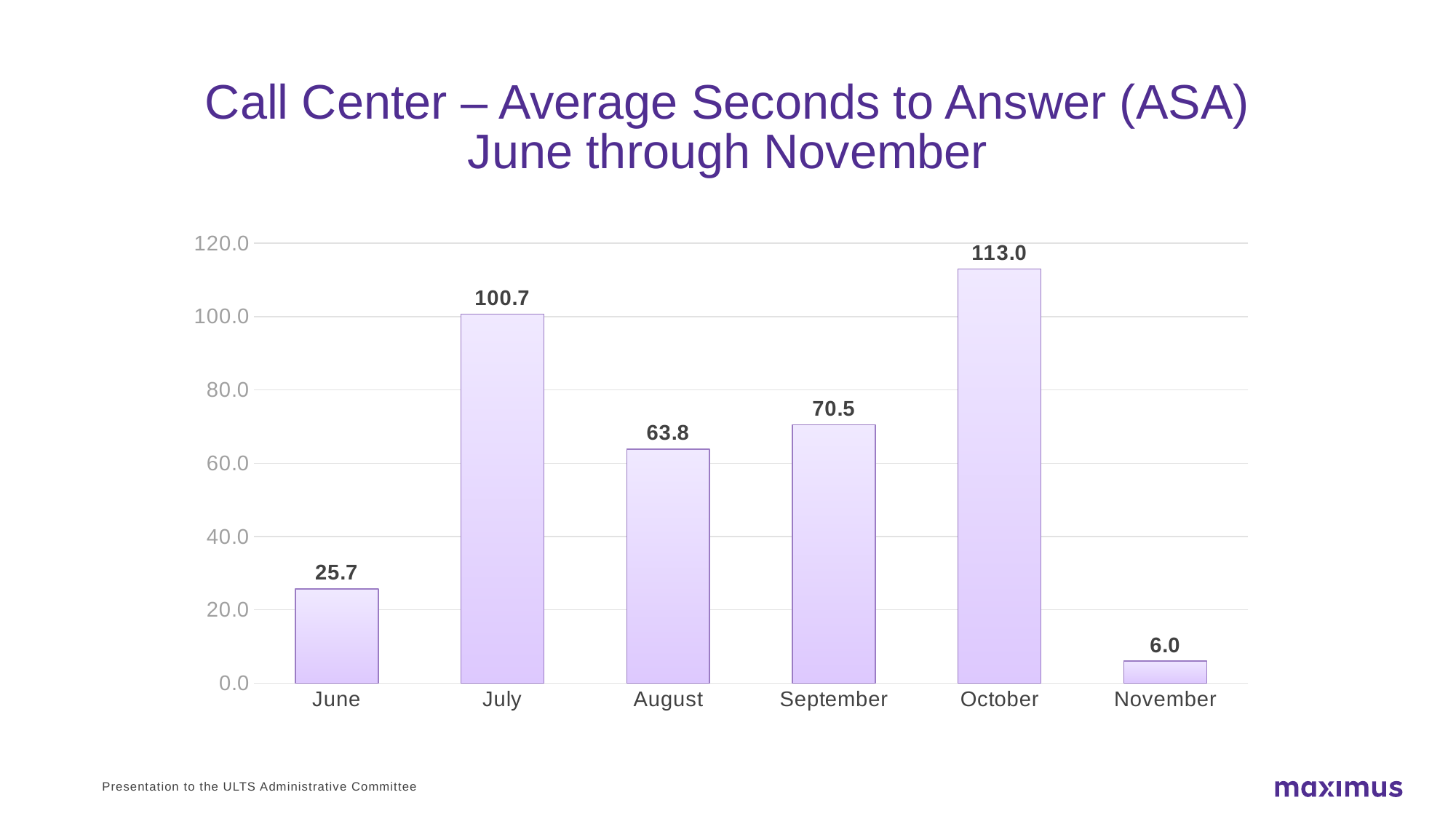
Which month has the lowest average seconds to answer? November Is the value for August greater or less than 60.0? greater Which month has the highest average seconds to answer? October How many months are shown on the chart? 6 What is the average seconds to answer for November? 6.0 What kind of chart is shown on the slide? Bar chart What is the average seconds to answer for September? 70.5 What is the title of the chart on the slide? Call Center – Average Seconds to Answer (ASA) June through November What is the average seconds to answer for July? 100.7 What is the difference between the October and June values? 87.3 What is the difference between the September and August values? 6.7 Which is larger, the value for July or the value for September? July